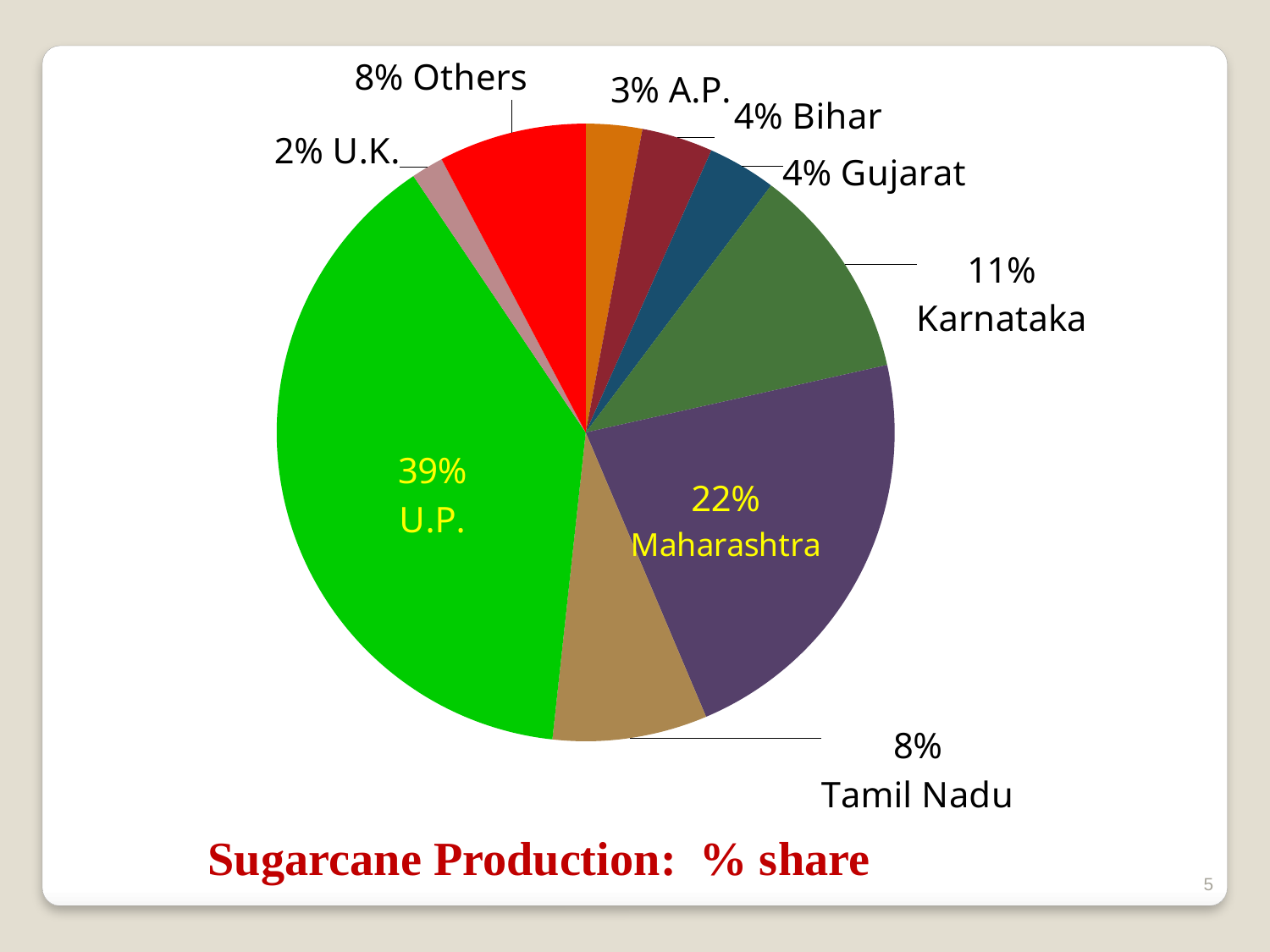
What is the percentage share shown for Tamil Nadu? 8% What is the percentage share shown for Karnataka? 11% What is the percentage share shown for U.K.? 2% How many percentage points larger is U.P.'s share than Maharashtra's share? 17 What share of sugarcane production does U.P. have? 39% How many slices does the pie chart have? 9 What is the title of the chart? Sugarcane Production: % share Which state has the largest share of sugarcane production? U.P. Which slice has the smallest share in the pie chart? U.K. What share of sugarcane production does Maharashtra have? 22% What kind of chart is shown on the slide? Pie chart Which has a larger share, Karnataka or Tamil Nadu? Karnataka